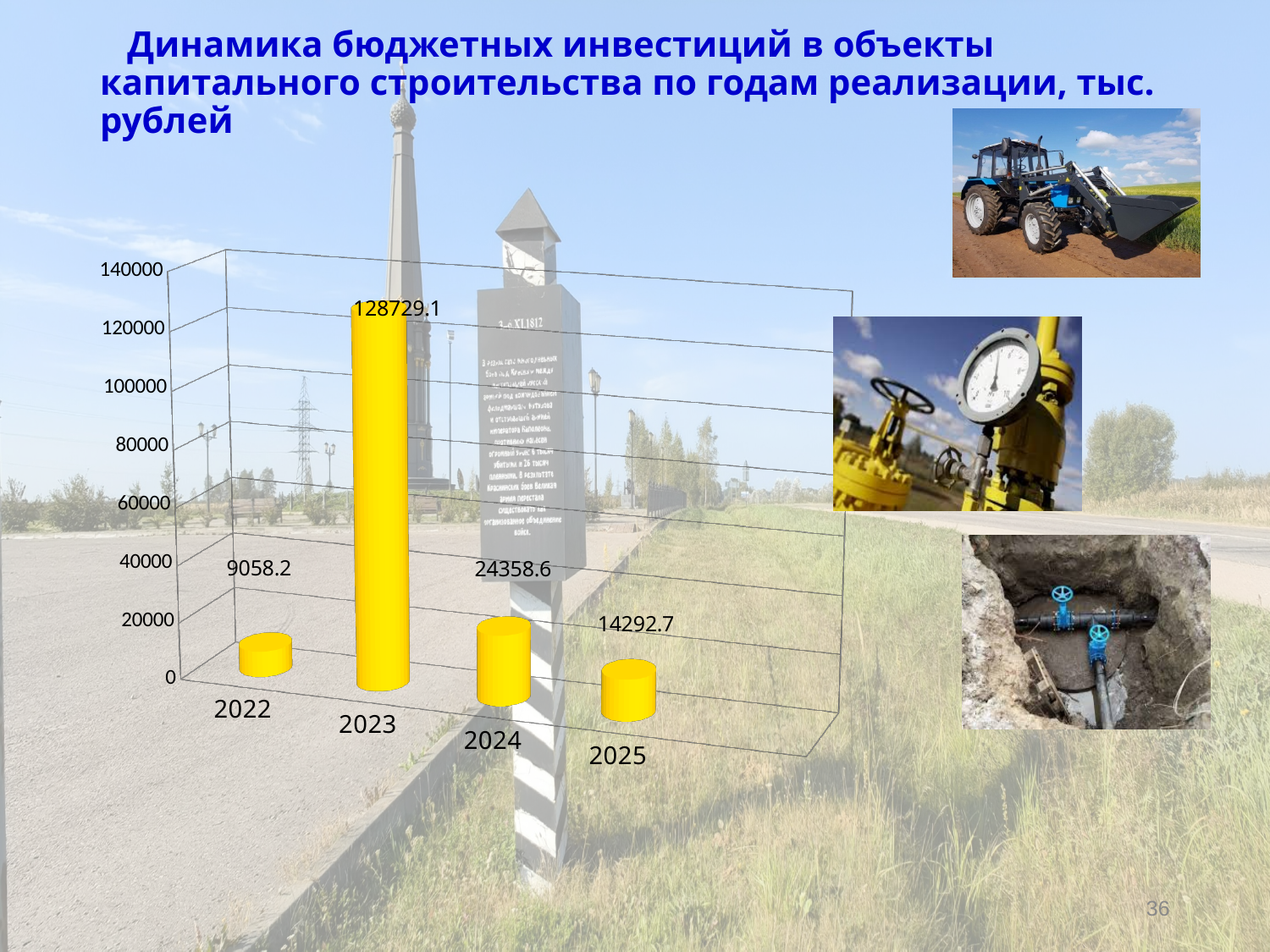
What unit is stated in the chart title? тыс. рублей What is the difference between the values for 2024 and 2025? 10065.9 What kind of chart is shown on the slide? bar chart Is the value for 2023 greater or less than 120000? greater What is the value for 2024? 24358.6 Which year has the highest value? 2023 Which is larger, the value for 2024 or the value for 2025? 2024 What is the value for 2022? 9058.2 What is the value for 2023? 128729.1 What is the value for 2025? 14292.7 Which year has the lowest value? 2022 How many years are shown on the x axis? 4